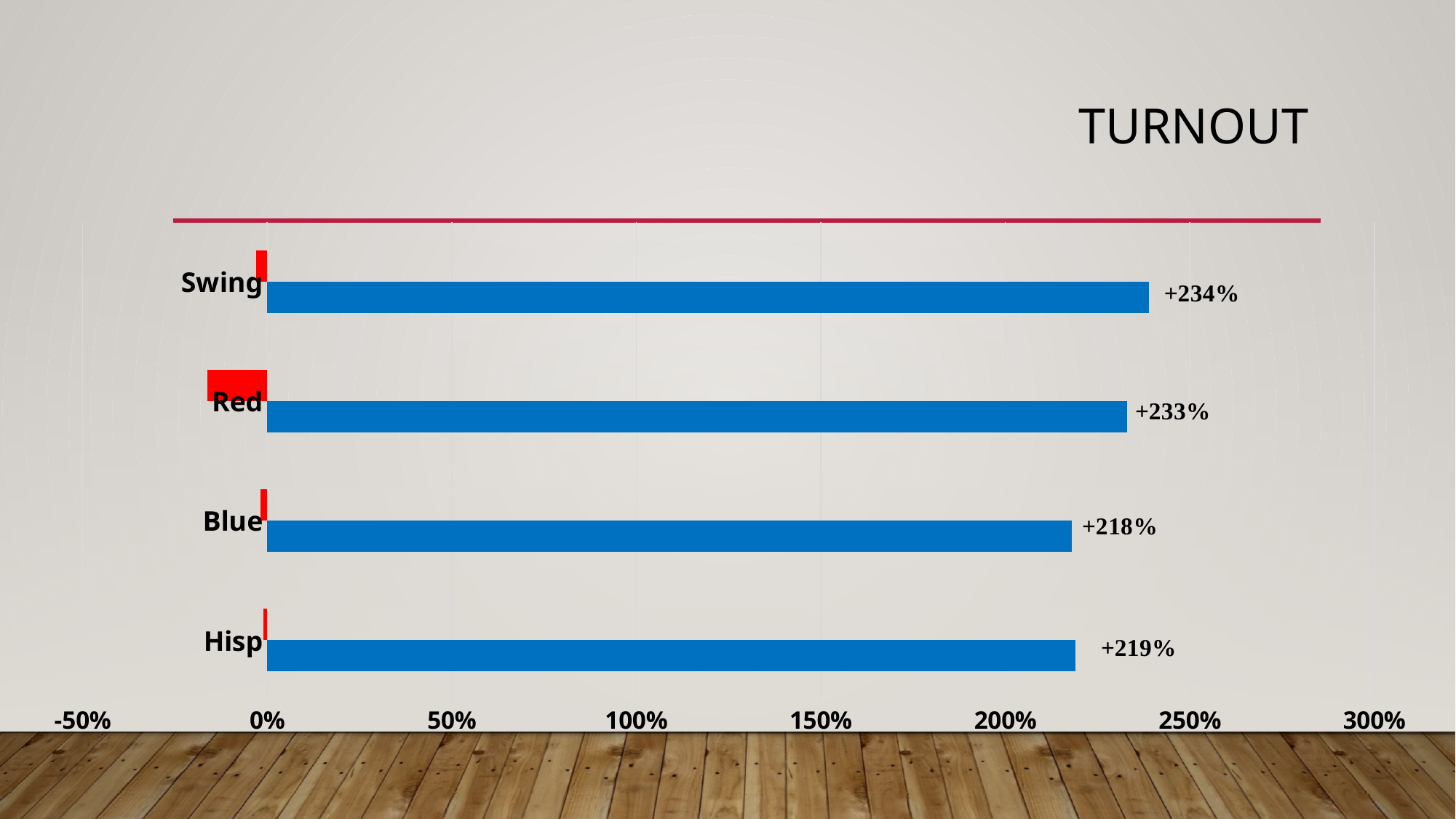
What is the value of the blue bar for Swing? +234% What is the value of the blue bar for Blue? +218% What kind of chart is shown on the slide? Bar chart Is the red bar for Red greater or less than 0%? less Which category has the highest labelled blue bar value? Swing What is the difference between the blue bar values for Swing and Blue? 16 percentage points What is the value of the blue bar for Red? +233% Which has a larger blue bar value, Red or Hisp? Red What is the value of the blue bar for Hisp? +219% Which category has the lowest labelled blue bar value? Blue How many categories are shown on the chart? 4 What is the title of the slide? TURNOUT